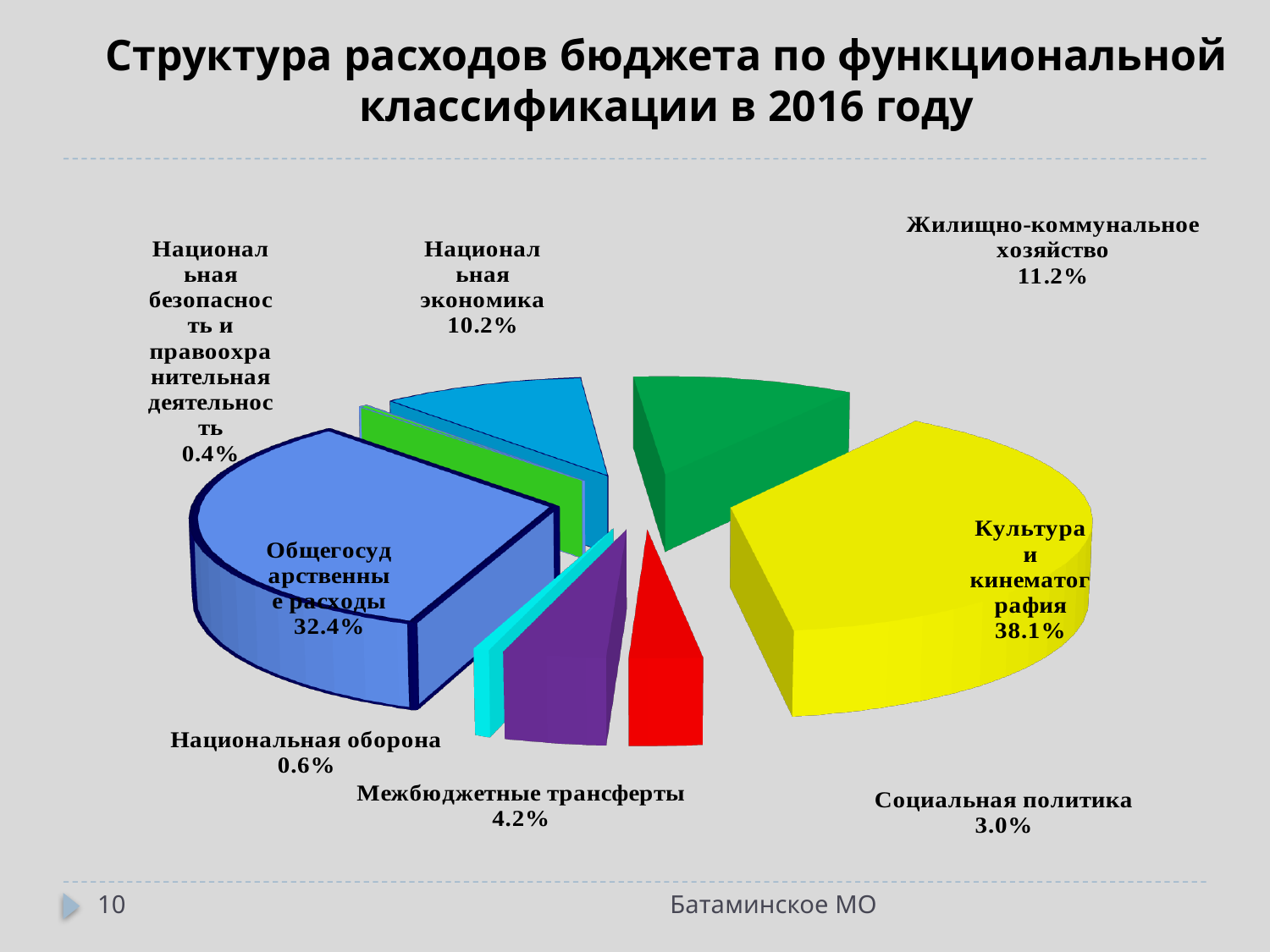
What kind of chart is shown on the slide? pie chart How many categories are shown in the pie chart? 8 What share of budget expenditure goes to Культура и кинематография? 38.1% What is the difference in percentage points between Культура и кинематография and Общегосударственные расходы? 5.7 Which category has the smallest share of budget expenditure? Национальная безопасность и правоохранительная деятельность What share of budget expenditure goes to Межбюджетные трансферты? 4.2% What is the title of the slide? Структура расходов бюджета по функциональной классификации в 2016 году Which category has the largest share of budget expenditure? Культура и кинематография Which is larger: the share for Жилищно-коммунальное хозяйство or for Национальная экономика? Жилищно-коммунальное хозяйство What share of budget expenditure goes to Жилищно-коммунальное хозяйство? 11.2% What share of budget expenditure goes to Национальная оборона? 0.6% What share of budget expenditure goes to Общегосударственные расходы? 32.4%